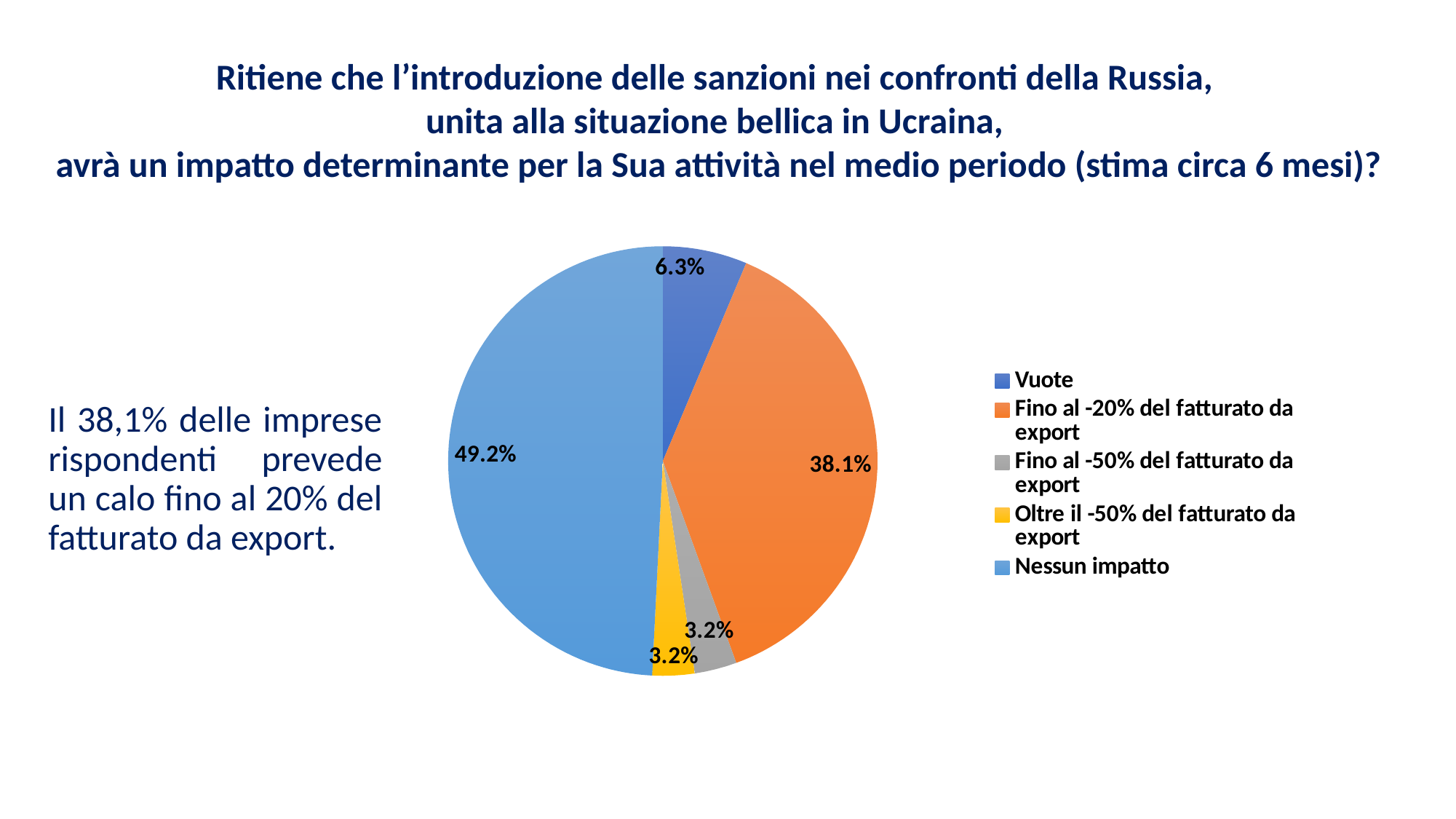
What share of the pie does "Oltre il -50% del fatturato da export" represent? 3.2% What colour is the slice for "Nessun impatto"? Light blue What share of the pie does "Vuote" represent? 6.3% What is the combined share of "Fino al -50% del fatturato da export" and "Oltre il -50% del fatturato da export"? 6.4% Which category has the largest slice of the pie? Nessun impatto What kind of chart is shown on the slide? Pie chart What is the difference in percentage points between "Nessun impatto" and "Fino al -20% del fatturato da export"? 11.1 What share of the pie does "Nessun impatto" represent? 49.2% How many categories does the legend list? 5 What share of the pie does "Fino al -20% del fatturato da export" represent? 38.1% Which legend entry is shown in yellow? Oltre il -50% del fatturato da export Which is larger: the slice for "Vuote" or the slice for "Fino al -50% del fatturato da export"? Vuote